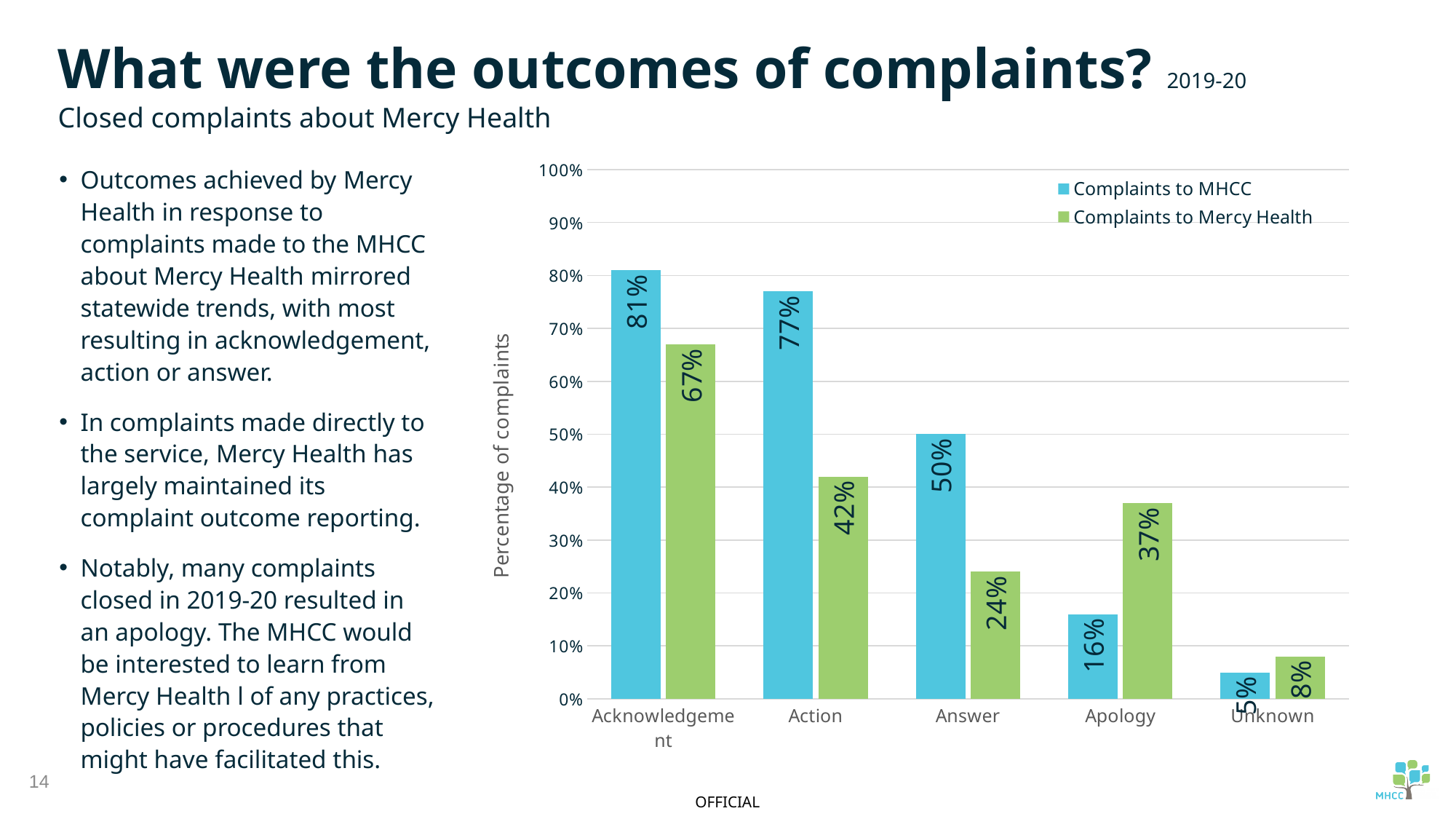
How many series does the legend list? 2 What percentage of complaints to Mercy Health resulted in Action? 42% Which outcome category has the lowest value for Complaints to Mercy Health? Unknown What kind of chart is shown on the slide? Bar chart How many outcome categories are shown on the x axis? 5 Which outcome category has the highest value for Complaints to MHCC? Acknowledgement Which colour represents Complaints to Mercy Health in the legend? Green For Apology, which series has the larger value: Complaints to MHCC or Complaints to Mercy Health? Complaints to Mercy Health What percentage of complaints to MHCC resulted in Acknowledgement? 81% What is the label of the y axis? Percentage of complaints What percentage of complaints to Mercy Health resulted in an Apology? 37% What is the difference between the Complaints to MHCC and Complaints to Mercy Health values for Answer? 26%